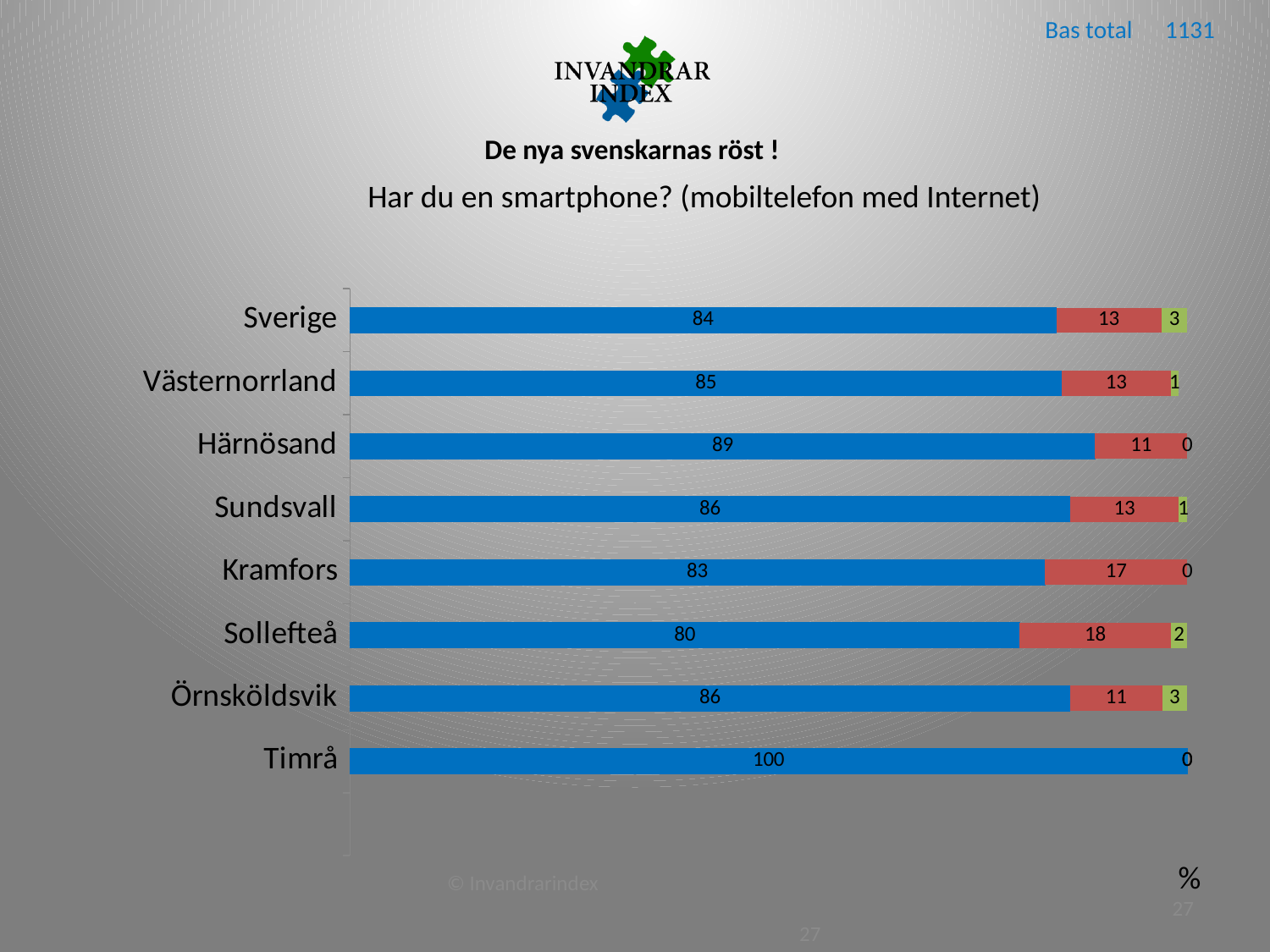
What question is the chart about, according to the title? Har du en smartphone? (mobiltelefon med Internet) Which category has the lowest value for the blue segment? Sollefteå What is the value of the green segment for Örnsköldsvik? 3 Which category has the highest value for the red segment? Sollefteå What kind of chart is shown on the slide? Stacked bar chart Which category has the highest value for the blue segment? Timrå Which has a larger red segment value, Kramfors or Sundsvall? Kramfors What is the total of the stacked bar for Sverige? 100 How many categories are shown on the chart? 8 What is the difference between the blue segment values for Härnösand and Sverige? 5 What is the value of the red segment for Sollefteå? 18 What is the value of the blue segment for Timrå? 100